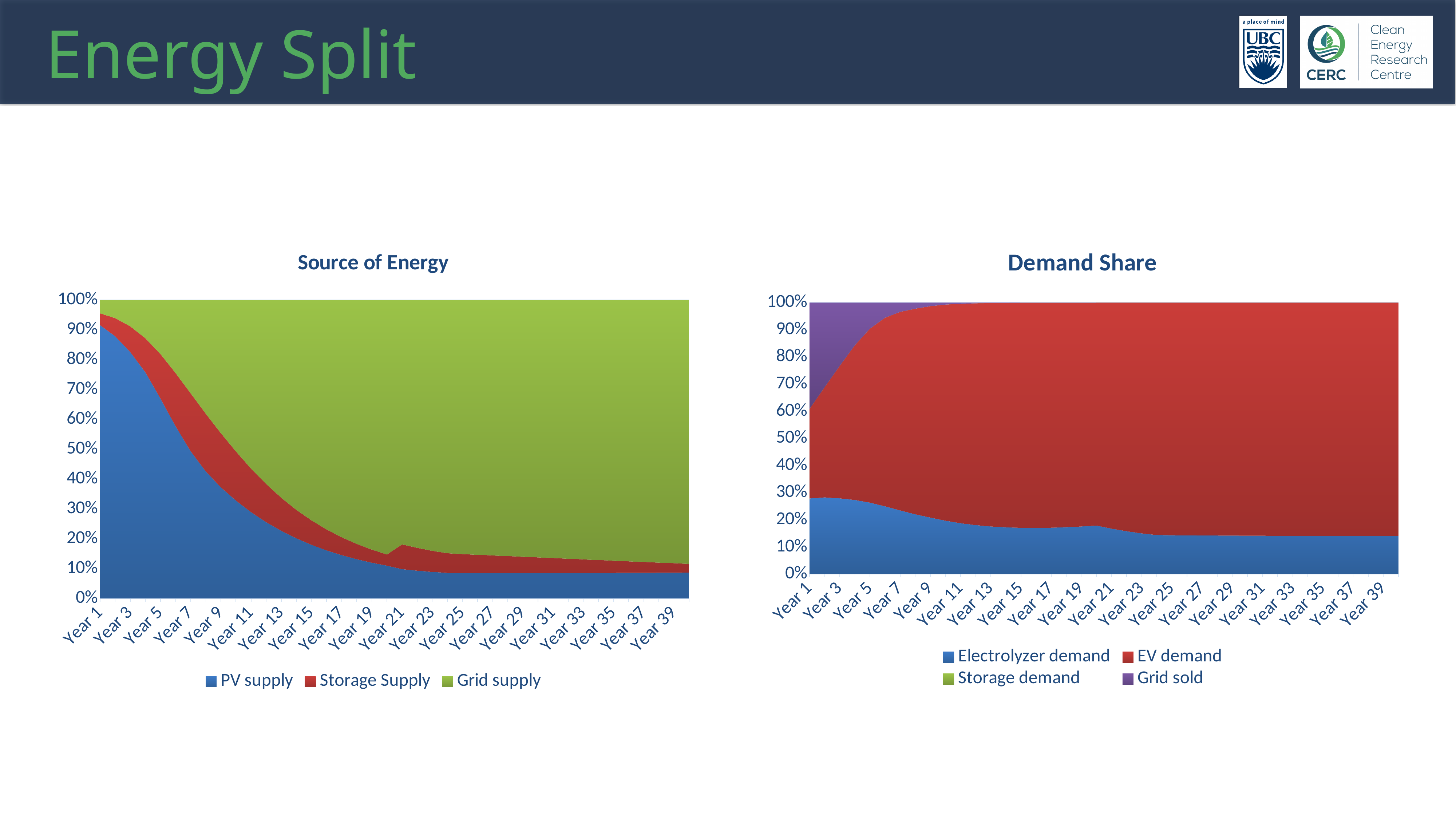
In the "Demand Share" chart, is the value for Electrolyzer demand at Year 1 greater or less than 20%? greater What kind of chart is the "Source of Energy" chart? Stacked area chart Which series in the "Demand Share" chart is shown in purple? Grid sold In the "Source of Energy" chart, is the value for PV supply at Year 39 greater or less than 20%? less In the "Demand Share" chart, does the Electrolyzer demand share rise or fall from Year 1 to Year 39? Fall How many series does the legend of the "Source of Energy" chart list? 3 What kind of chart is the "Demand Share" chart? Stacked area chart In the "Source of Energy" chart, is the value for PV supply at Year 1 greater or less than 80%? greater In the "Source of Energy" chart, does the Grid supply share rise or fall from Year 1 to Year 39? Rise In the "Source of Energy" chart, does the PV supply share rise or fall from Year 1 to Year 39? Fall How many series does the legend of the "Demand Share" chart list? 4